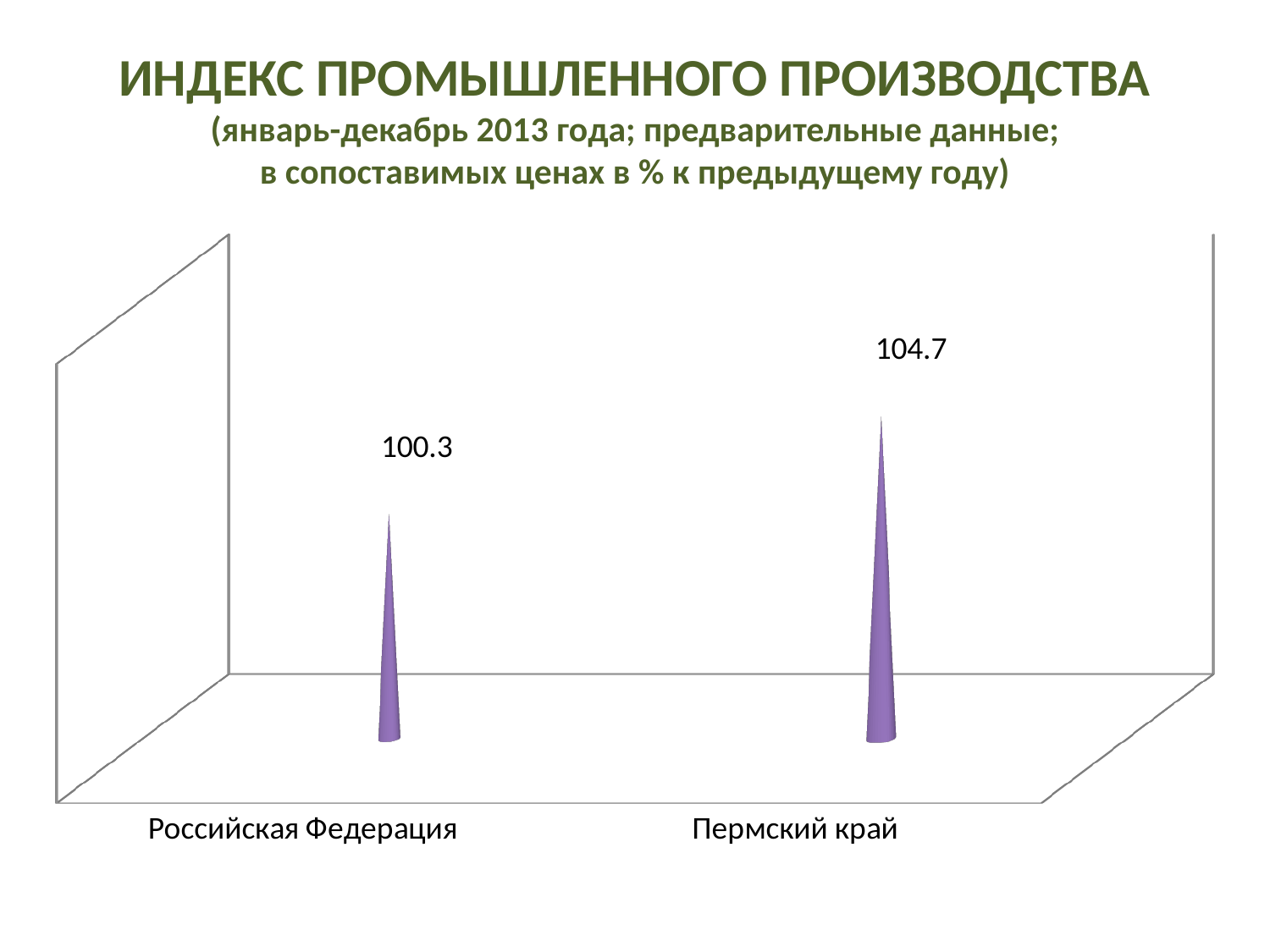
What colour are the bars on the chart? purple Which category has the highest value? Пермский край What kind of chart is shown on the slide? bar chart Which is larger, the value for Российская Федерация or the value for Пермский край? Пермский край What is the value for Российская Федерация? 100.3 What is the difference between the values for Пермский край and Российская Федерация? 4.4 How many categories are shown on the chart? 2 What is the value for Пермский край? 104.7 Do the values rise or fall from Российская Федерация to Пермский край? rise Which category has the lowest value? Российская Федерация What is the title of the chart? ИНДЕКС ПРОМЫШЛЕННОГО ПРОИЗВОДСТВА